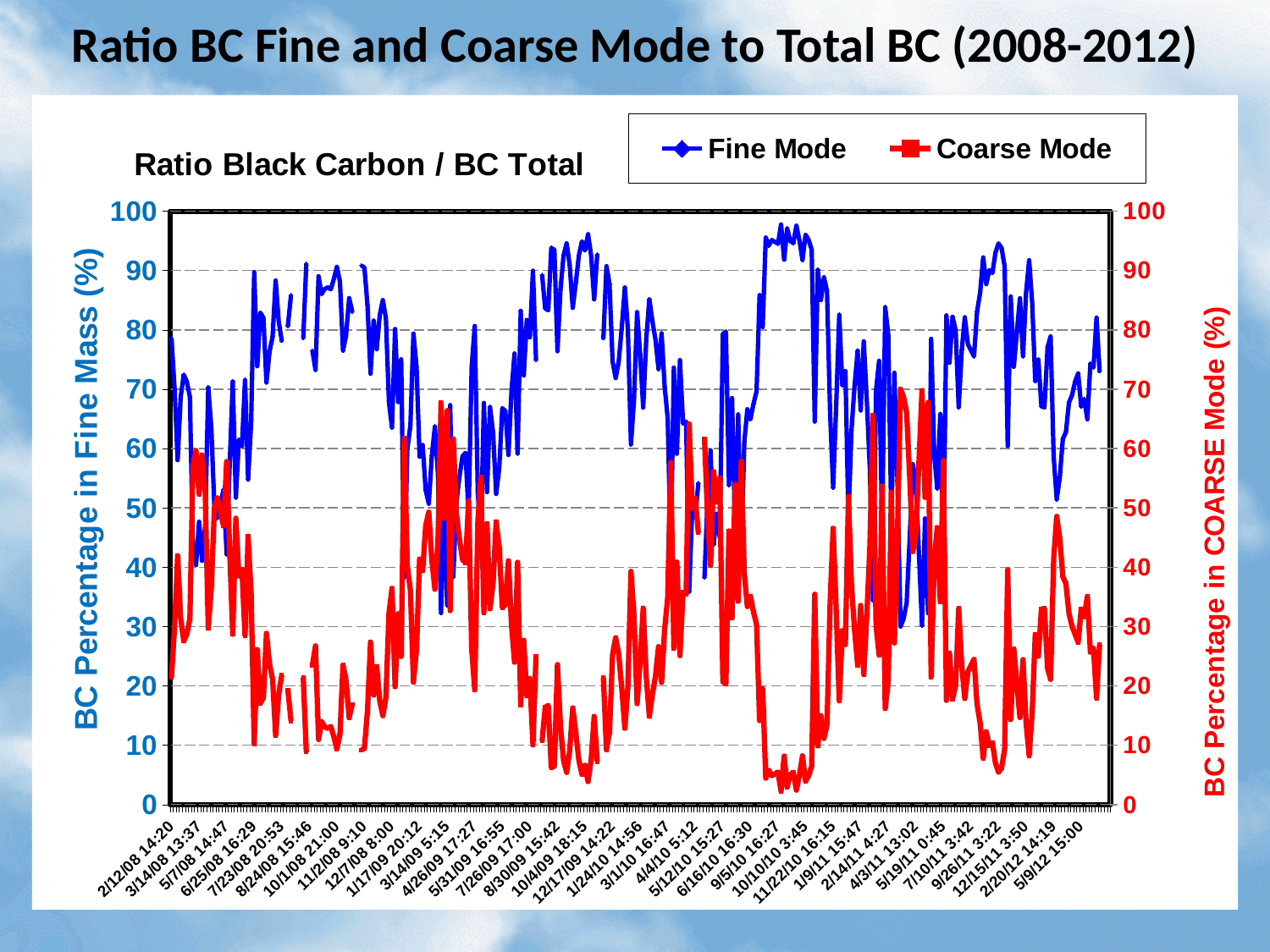
Around 10/10/10 3:45, which series has the larger value, Fine Mode or Coarse Mode? Fine Mode What is the title printed above the chart area? Ratio Black Carbon / BC Total How many series does the legend list? 2 What is the maximum value shown on the left vertical axis? 100 Is the Fine Mode value around 10/10/10 3:45 greater or less than 90? greater Which series is drawn in red? Coarse Mode Is the Fine Mode value around 10/4/09 18:15 greater or less than 80? greater What are the two series named in the legend? Fine Mode and Coarse Mode What kind of chart is shown on the slide? line chart Is the Coarse Mode value around 10/10/10 3:45 greater or less than 10? less